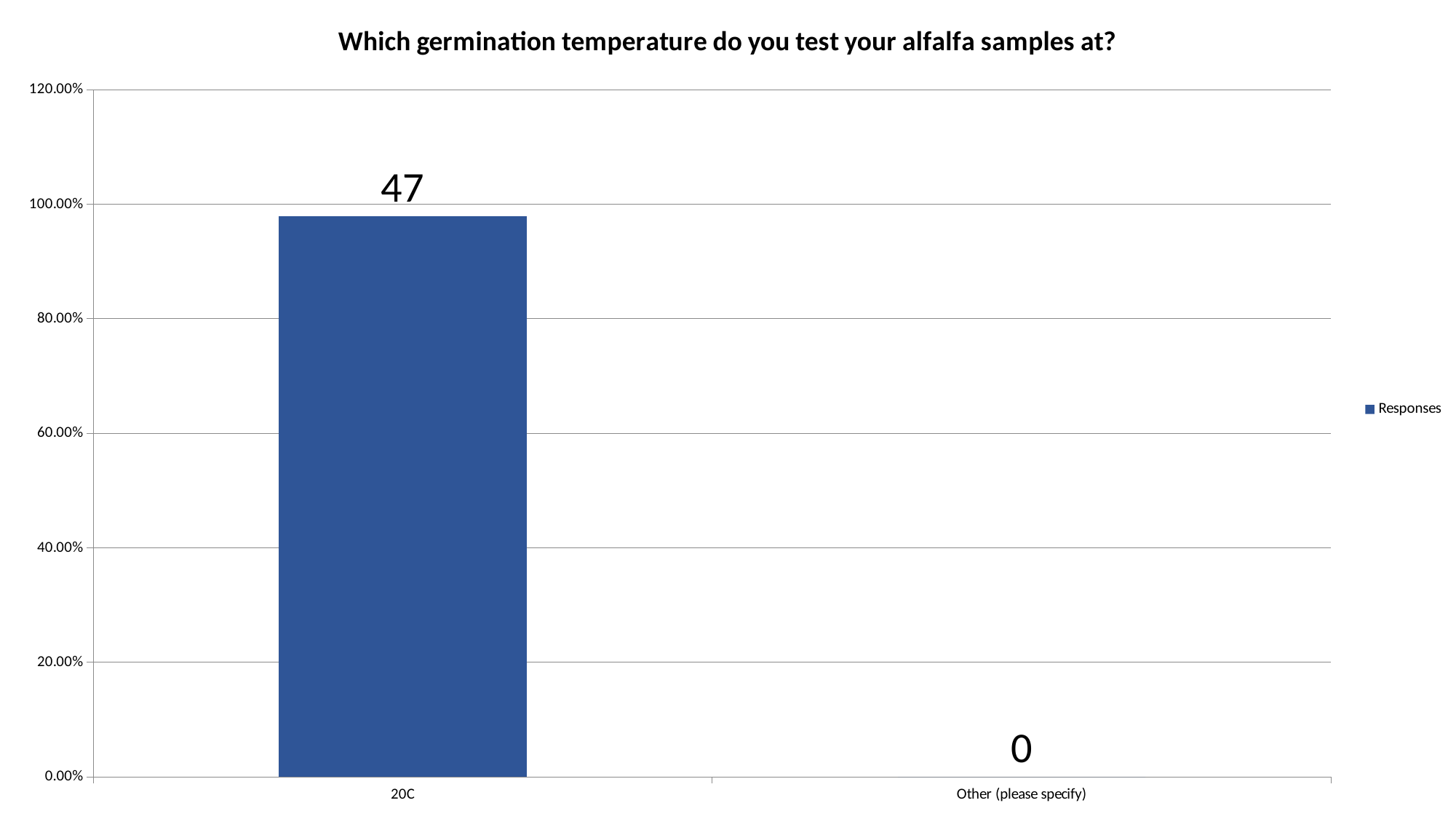
Which category has the lowest value? Other (please specify) What data label is shown above the bar for 20C? 47 How many series does the legend list? 1 Is the bar for 20C greater or less than 60.00% on the axis? greater How many categories are shown on the x axis? 2 What kind of chart is shown on the slide? bar chart Is the bar for 20C greater or less than 80.00% on the axis? greater What is the title of the chart? Which germination temperature do you test your alfalfa samples at? Which category has the highest value? 20C What is the difference between the data labels for 20C and Other (please specify)? 47 Which is larger, the value for 20C or the value for Other (please specify)? 20C What data label is shown for Other (please specify)? 0